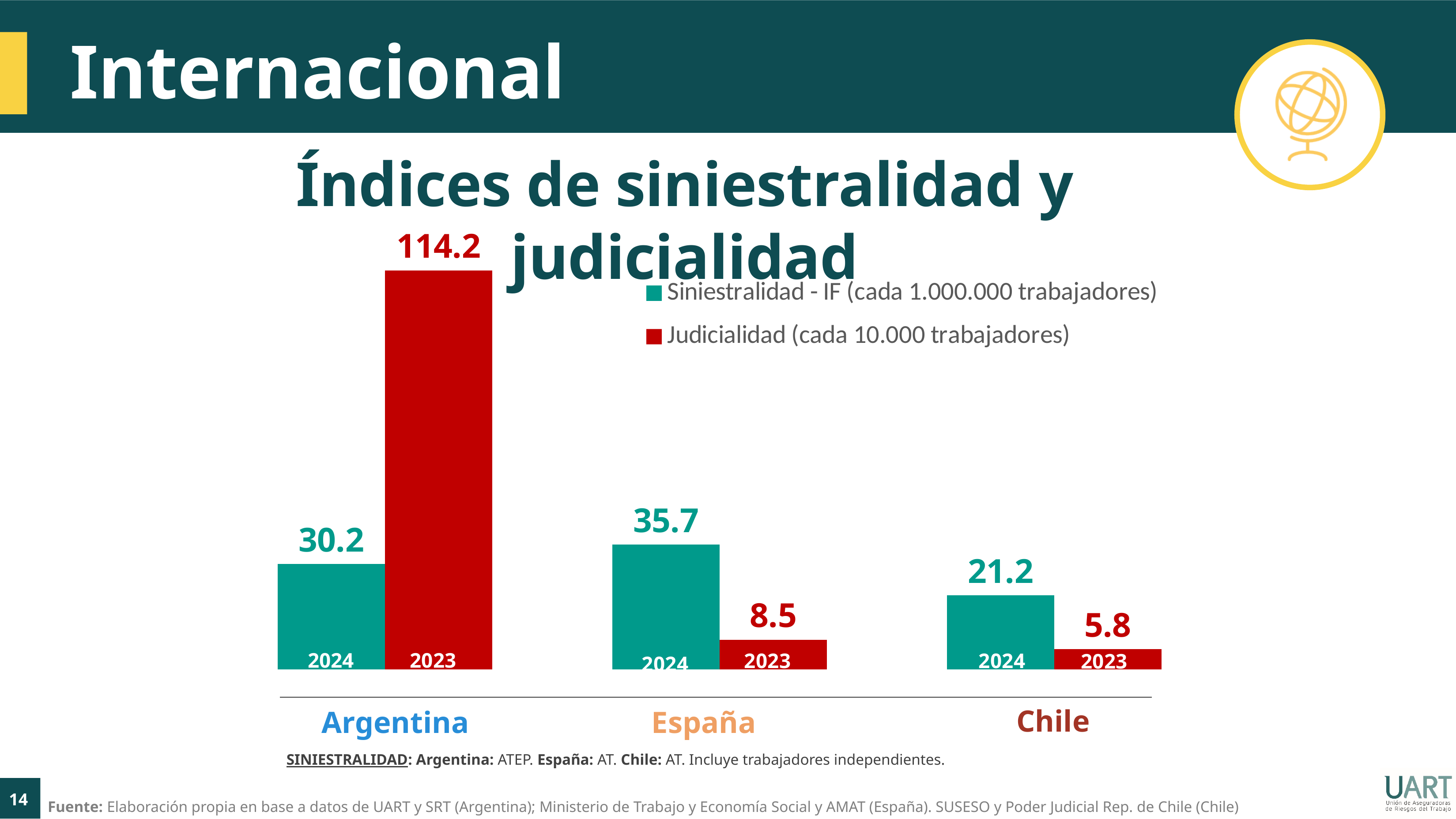
What is the Judicialidad value for Argentina? 114.2 How many series does the chart legend list? 2 Which is larger, the Siniestralidad - IF value for Chile or the Judicialidad value for Chile? Siniestralidad - IF value for Chile What is the Judicialidad value for Chile? 5.8 Which country has the highest Siniestralidad - IF value? España Which year is labelled on the Judicialidad bars? 2023 What is the Siniestralidad - IF value for España? 35.7 How many countries are shown on the x axis of the chart? 3 What is the Siniestralidad - IF value for Argentina? 30.2 Which country has the lowest Judicialidad value? Chile What is the difference between the Judicialidad values for Argentina and España? 105.7 What type of chart is shown on the slide? Bar chart